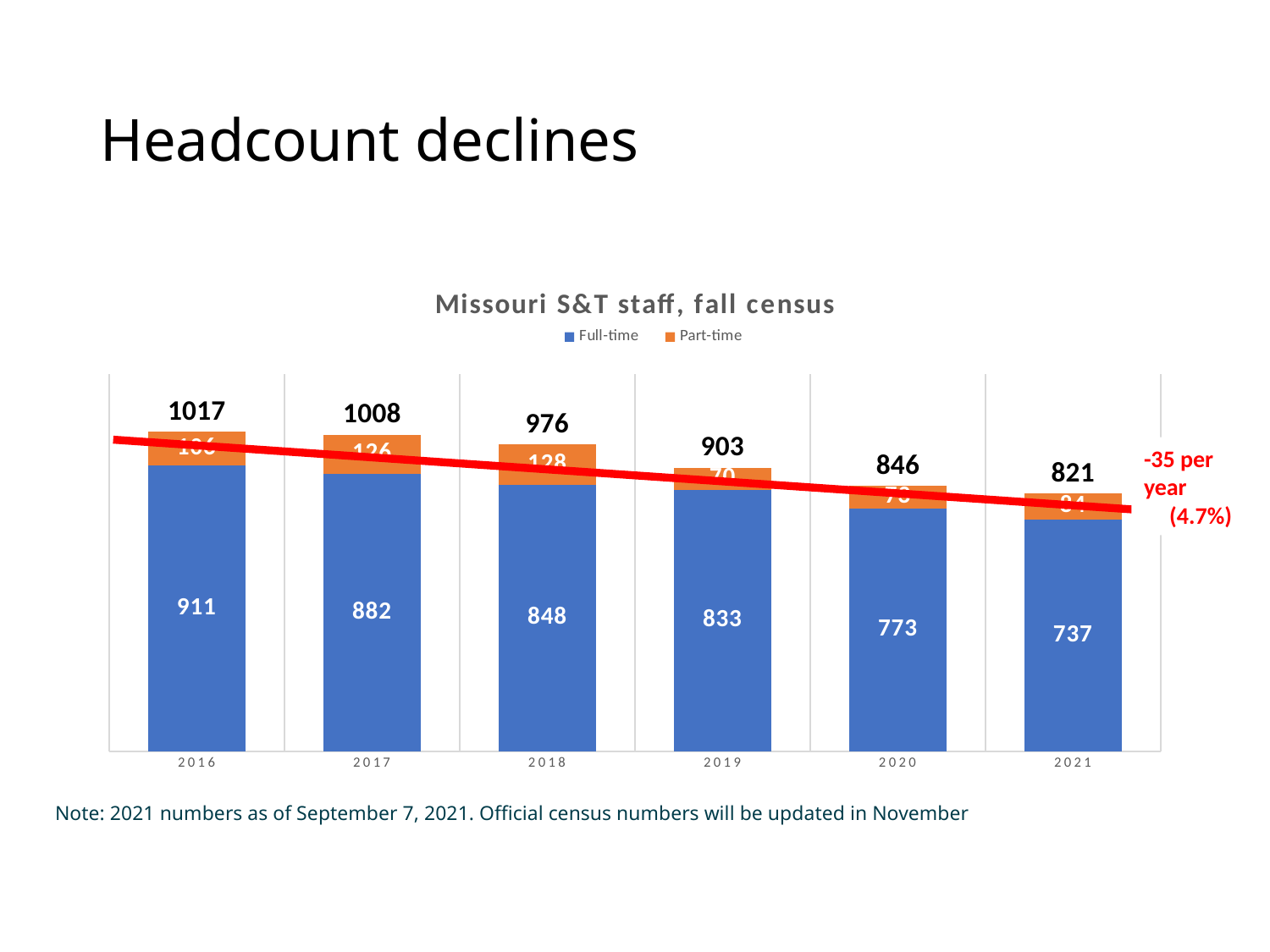
What kind of chart is shown on the slide? bar chart How many series does the legend list? 2 How many years are shown on the x axis? 6 What is the difference between the total headcounts for 2017 and 2018? 32 Which is larger, the Full-time value for 2018 or for 2019? 2018 What is the total staff headcount shown for 2019? 903 What is the difference between the Full-time values for 2016 and 2021? 174 What is the total staff headcount shown for 2021? 821 Which year has the lowest Full-time value? 2021 Do the total headcounts rise or fall from 2016 to 2021? fall Which year has the highest total headcount? 2016 What is the Full-time value for 2016? 911